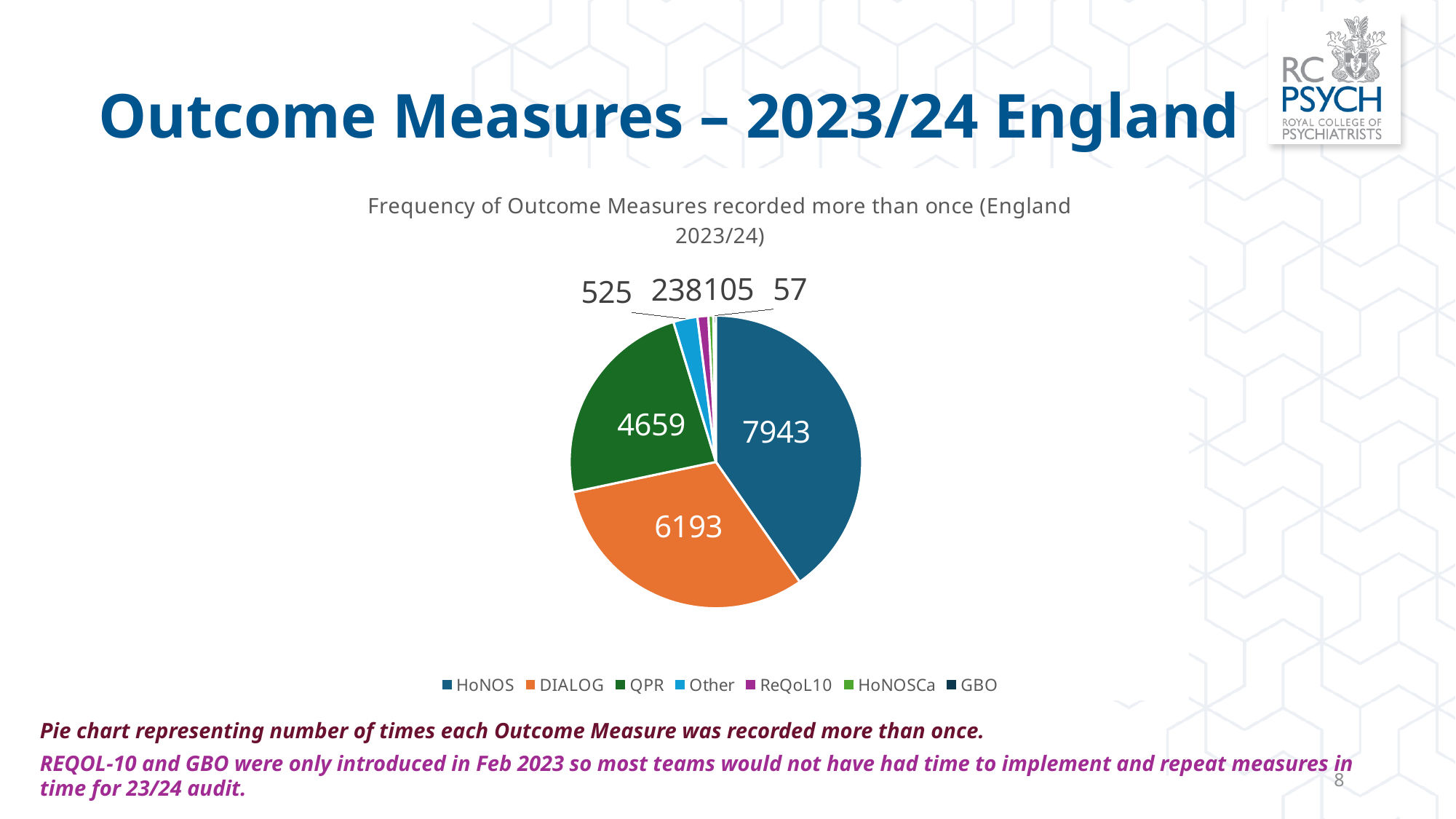
Which is larger, the value for DIALOG or the value for QPR? DIALOG What is the value for QPR in the pie chart? 4659 What is the value for GBO in the pie chart? 57 What is the difference between the HoNOS and DIALOG values? 1750 What is the value for DIALOG in the pie chart? 6193 What is the value for HoNOS in the pie chart? 7943 What is the value for Other in the pie chart? 525 What is the title of the pie chart? Frequency of Outcome Measures recorded more than once (England 2023/24) What type of chart is shown on the slide? Pie chart Which outcome measure has the largest slice in the pie chart? HoNOS Which outcome measure has the smallest slice in the pie chart? GBO How many categories does the legend of the pie chart list? 7